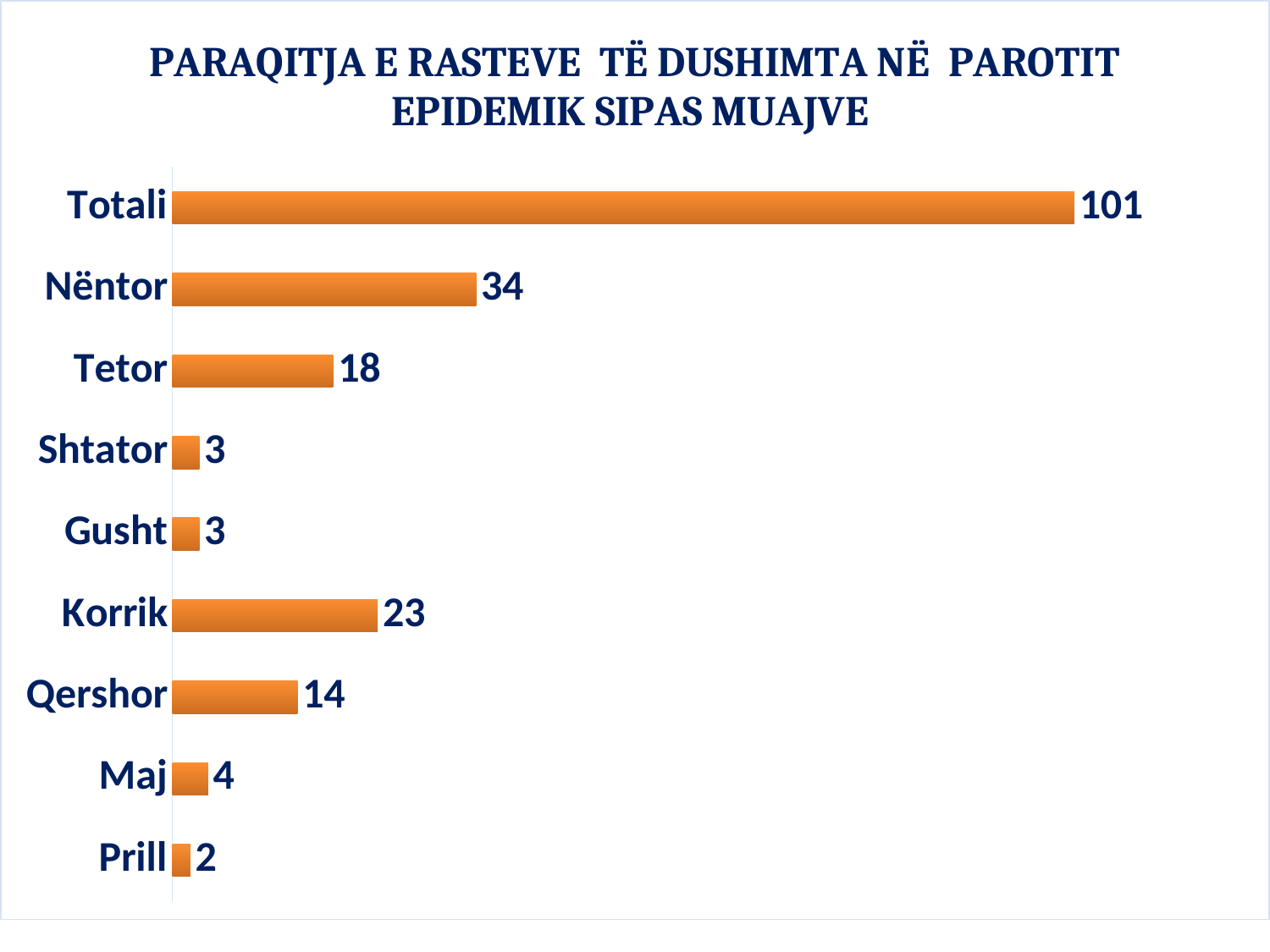
Which category has the lowest value? Prill Which is larger, the value for Tetor or the value for Korrik? Korrik How many categories are shown on the chart? 9 What is the value for Qershor? 14 What is the value for Korrik? 23 What is the difference between the values for Korrik and Qershor? 9 Which month has the highest value? Nëntor What is the value for Nëntor? 34 What is the difference between the values for Nëntor and Tetor? 16 What is the value shown for Totali? 101 What colour are the bars in the chart? Orange What kind of chart is shown on the slide? Bar chart